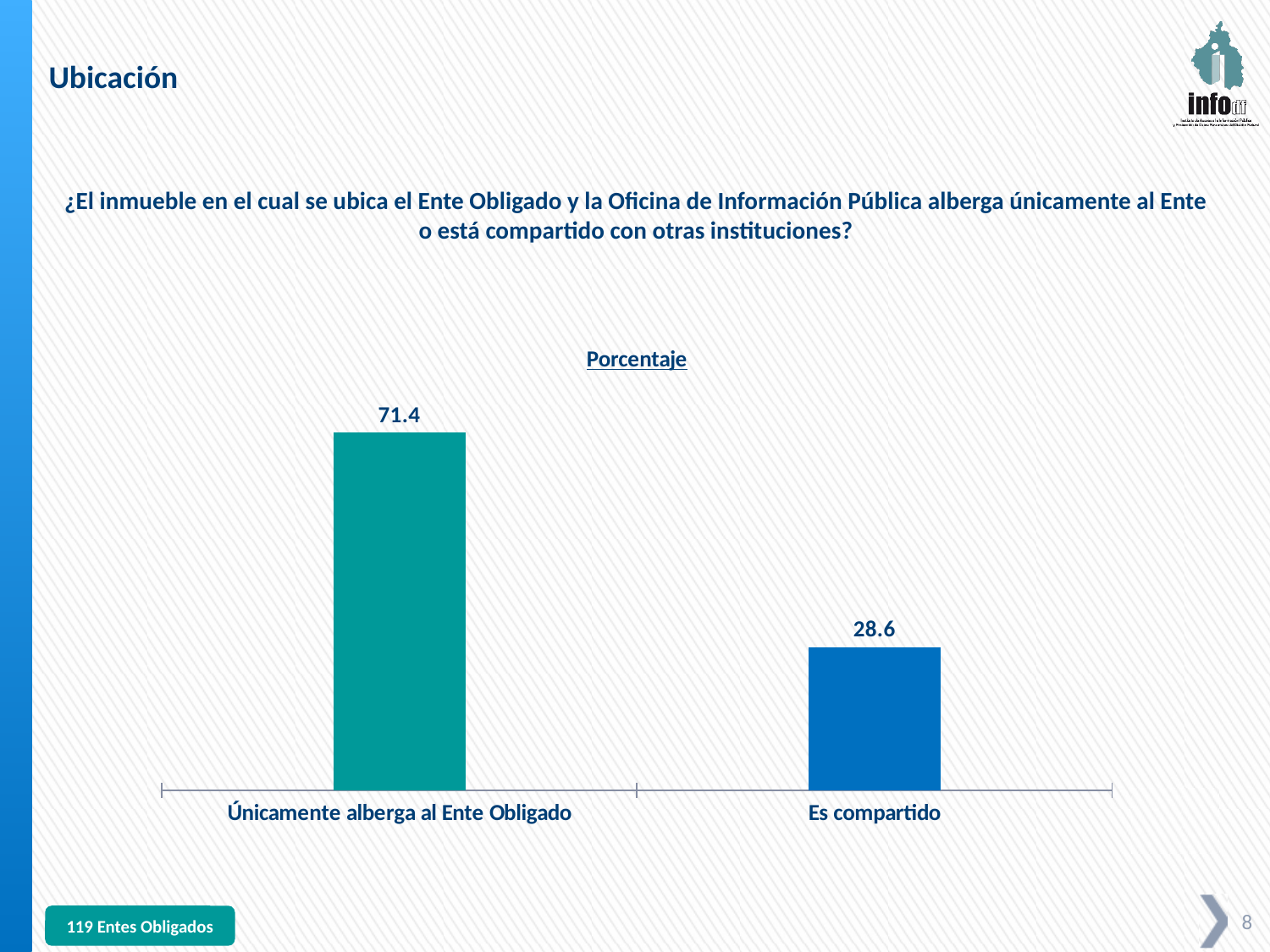
Which is larger, the value for "Únicamente alberga al Ente Obligado" or the value for "Es compartido"? Únicamente alberga al Ente Obligado How many categories are shown in the chart? 2 What is the value for "Es compartido"? 28.6 Which category has the lowest value? Es compartido What is the total of the two values shown in the chart? 100 What is the difference between the values for "Únicamente alberga al Ente Obligado" and "Es compartido"? 42.8 Which category has the highest value? Únicamente alberga al Ente Obligado What colour is the bar for "Es compartido"? Blue What is the title of the chart? Porcentaje What kind of chart is shown on the slide? Bar chart What is the value for "Únicamente alberga al Ente Obligado"? 71.4